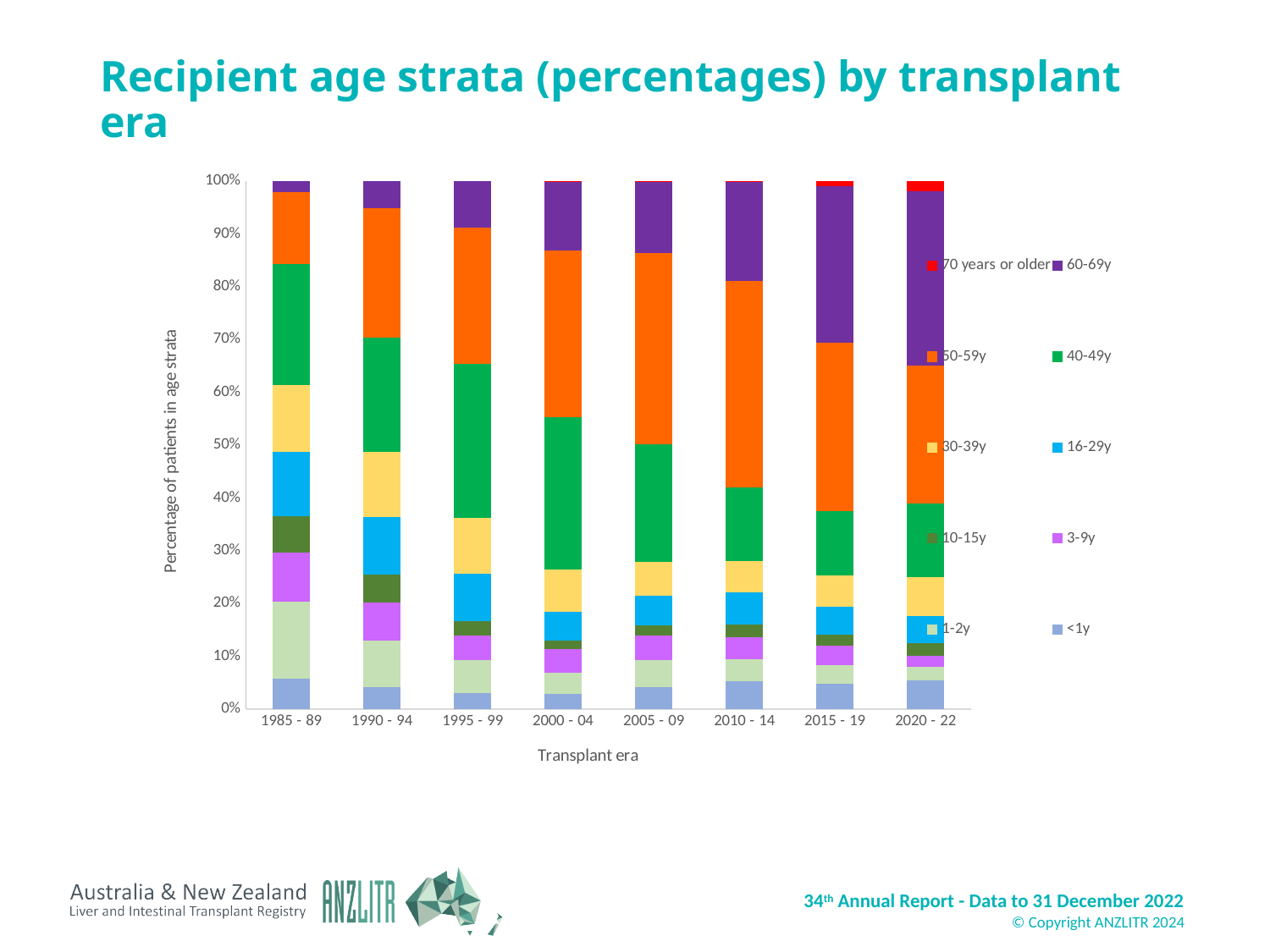
What does each stacked bar total? 100% How many transplant eras are shown on the x axis? 8 Does the share of recipients aged 60-69y rise or fall across the transplant eras from 1985 - 89 to 2020 - 22? Rise In 2020 - 22, is the combined share of recipients younger than 50 years greater or less than 50%? less What kind of chart is shown on the slide? Stacked bar chart Does the share of recipients aged 40-49y rise or fall across the transplant eras from 1985 - 89 to 2020 - 22? Fall Which era has the largest 40-49y segment? 1995 - 99 What is the title of the chart? Recipient age strata (percentages) by transplant era What is the label of the y axis? Percentage of patients in age strata Is the 60-69y segment larger in 2020 - 22 or in 1985 - 89? 2020 - 22 Which era has the largest 60-69y segment? 2020 - 22 How many age strata series does the legend list? 10